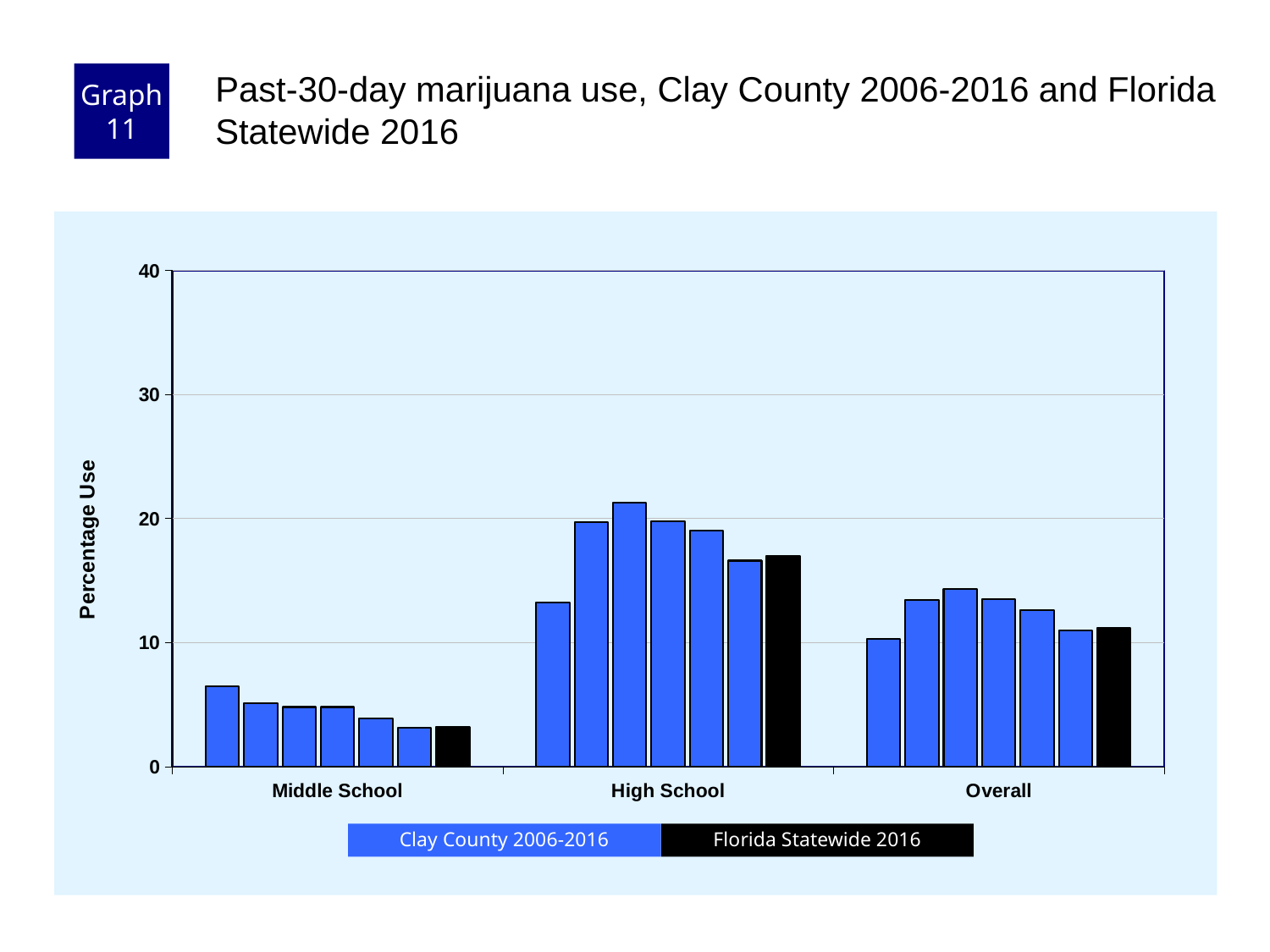
Which is larger, the Florida Statewide 2016 value for High School or for Overall? High School How many series does the legend list? 2 How many school-level categories are shown on the x axis? 3 What kind of chart is shown on the slide? bar chart Which category has the lowest bars overall? Middle School What colour represents Florida Statewide 2016 in the legend? black Is the Florida Statewide 2016 value for Middle School greater or less than 10? less Is the tallest Clay County bar in the High School group greater or less than 20? greater Which category has the highest bars overall? High School What is the label on the y axis? Percentage Use Is the Florida Statewide 2016 value for High School greater or less than 20? less